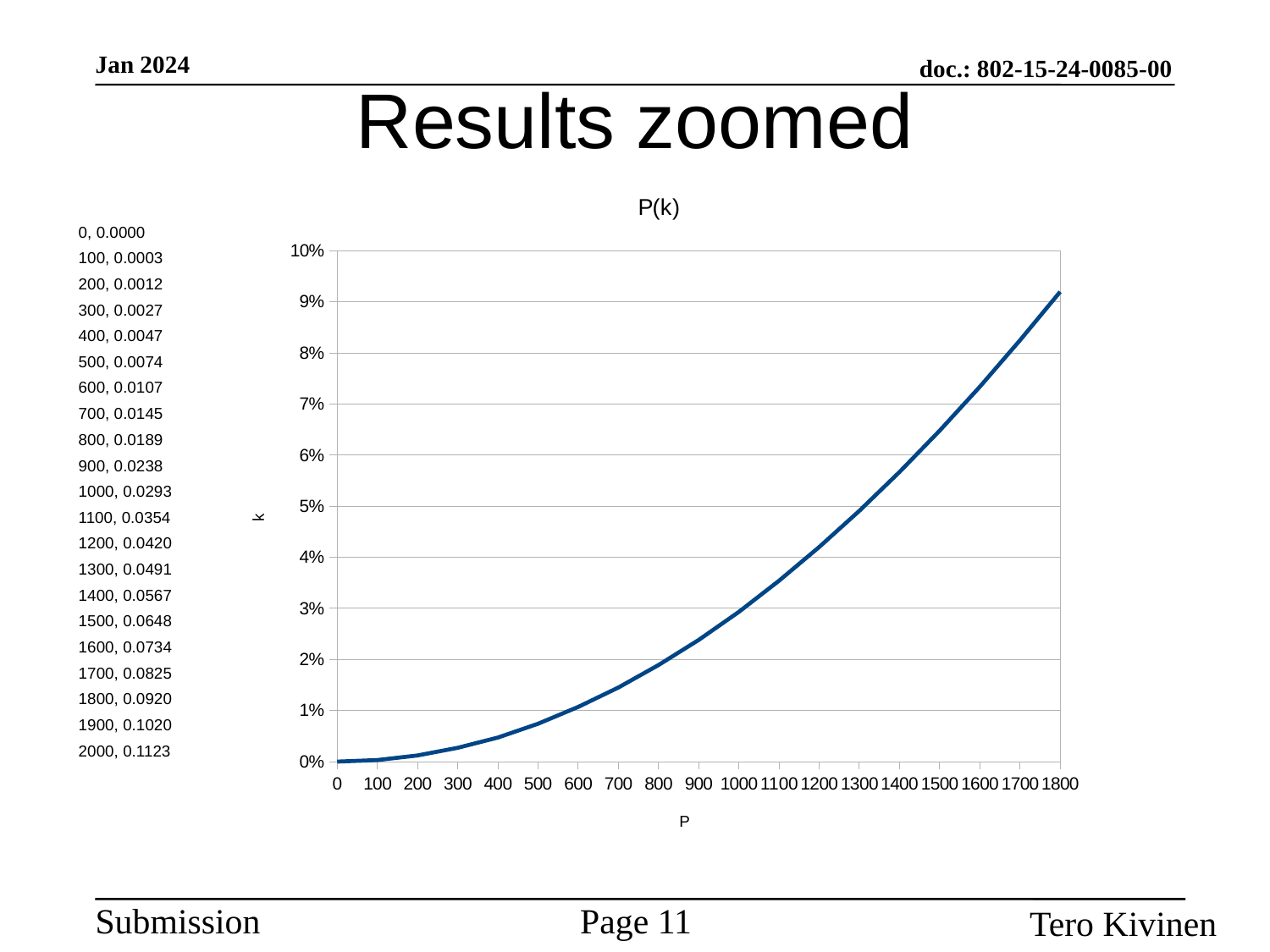
According to the list of values printed to the left of the chart, what is the value for 1000? 0.0293 Is the plotted value at P = 1800 greater or less than 8%? greater What kind of chart is shown on the slide? line chart At which value of P does the plotted line reach its highest point on the chart? 1800 What is the difference between the listed values for 2000 and 1900? 0.0103 Is the plotted value at P = 1000 greater or less than 4%? less According to the list of values printed to the left of the chart, what is the value for 1800? 0.0920 Is the plotted value at P = 500 greater or less than 1%? less How many data pairs are listed to the left of the chart? 21 What is the title of the chart? P(k) Does the plotted value rise or fall as P increases along the x axis? rises